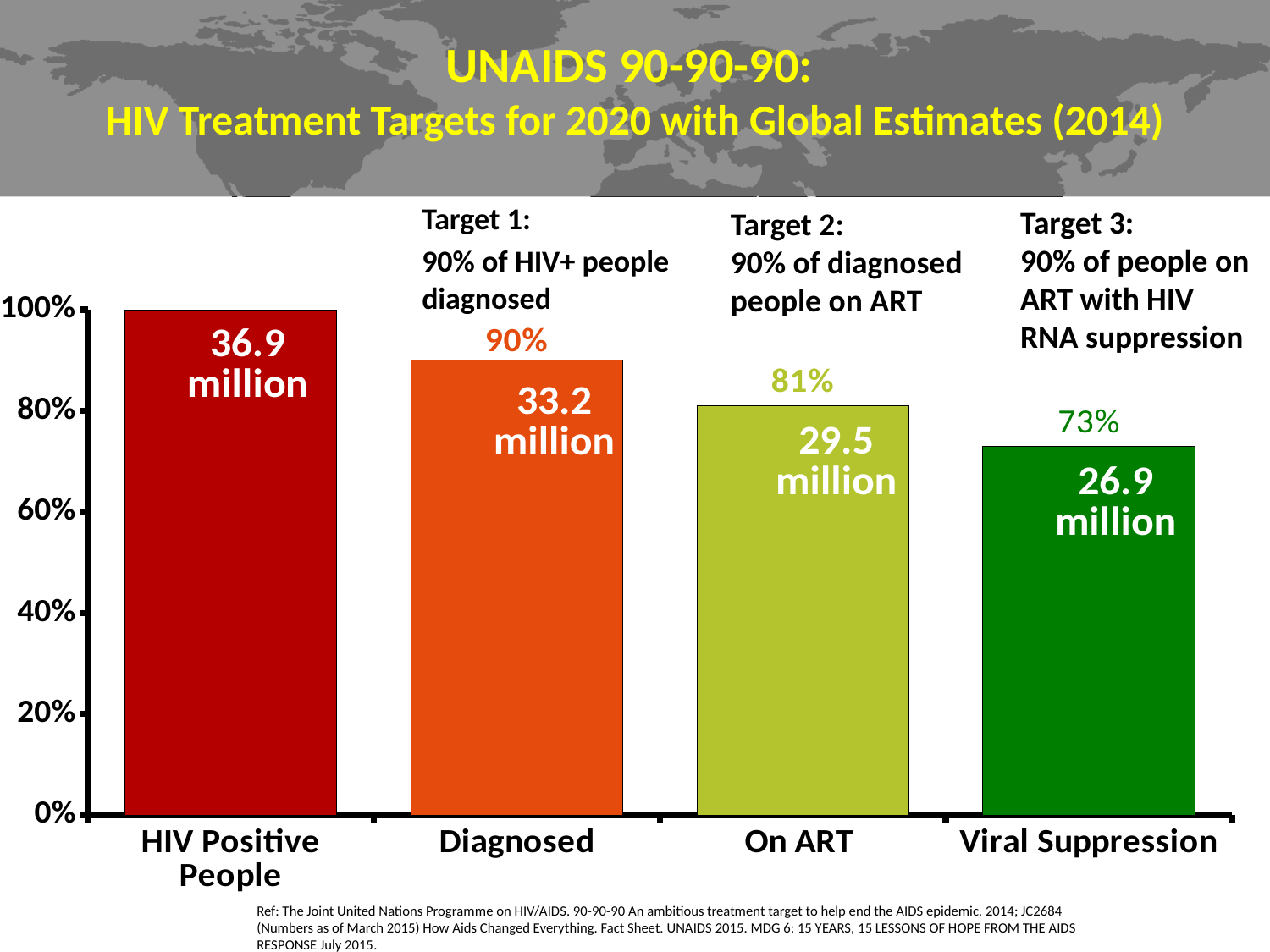
What percentage is printed above the Diagnosed bar? 90% What percentage is printed above the On ART bar? 81% Which category has the lowest bar? Viral Suppression How many categories are shown on the x axis of the chart? 4 How many people are labelled on the HIV Positive People bar? 36.9 million How many people are labelled on the Viral Suppression bar? 26.9 million What percentage is printed above the Viral Suppression bar? 73% How many people are labelled on the On ART bar? 29.5 million What is the difference in percentage points between the Diagnosed bar (90%) and the Viral Suppression bar (73%)? 17 Do the bar values rise or fall from left to right along the x axis? fall Which category has the highest bar? HIV Positive People What kind of chart is shown on the slide? bar chart